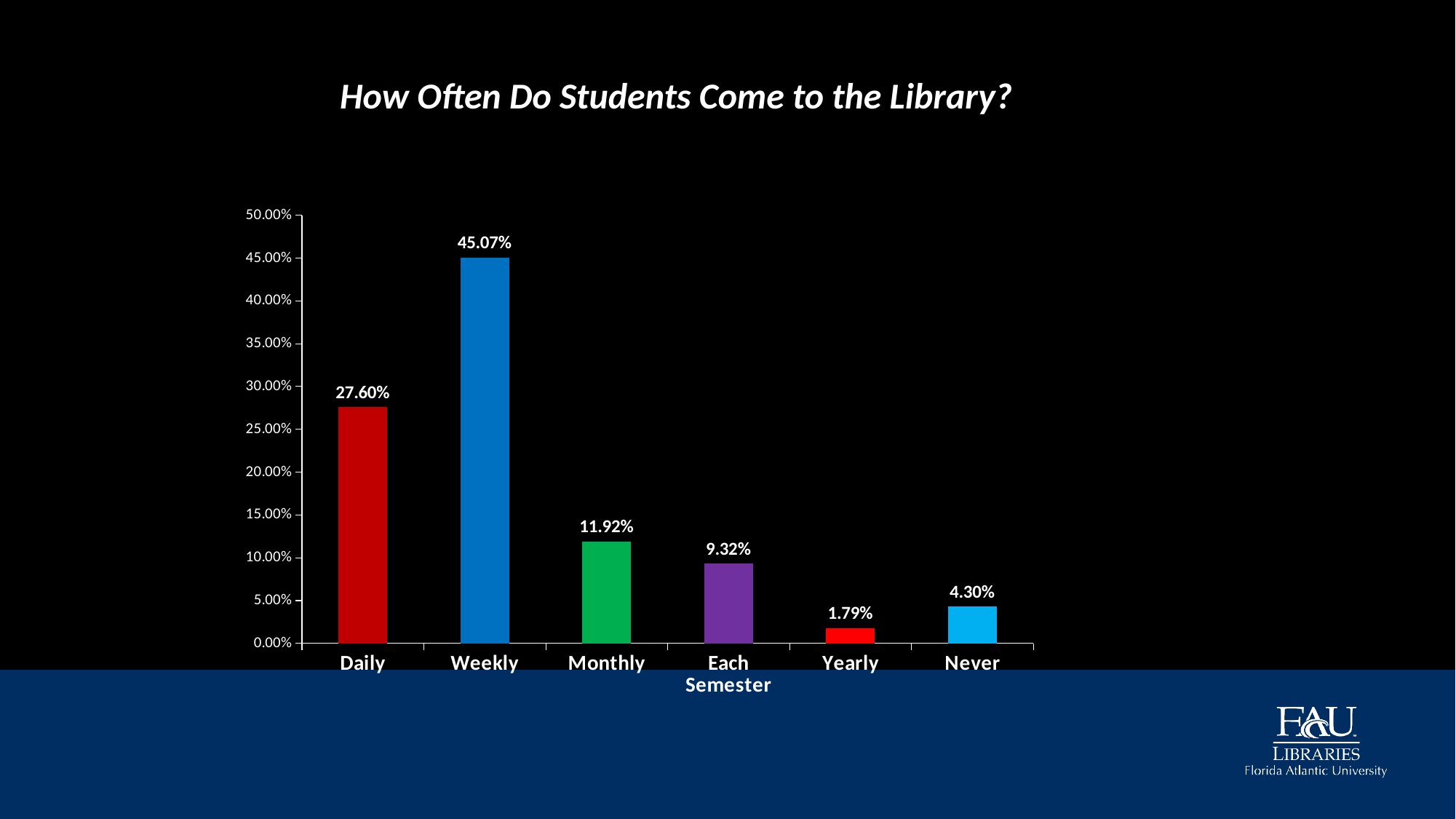
What is the value shown for Never? 4.30% How many categories are shown on the x axis? 6 What percentage of students come to the library weekly? 45.07% What percentage of students come to the library each semester? 9.32% Which category has the lowest value? Yearly Which category has the highest value? Weekly What is the value shown for Daily? 27.60% What is the title of the chart? How Often Do Students Come to the Library? Which is larger, the value for Monthly or the value for Never? Monthly What is the difference between the Monthly and Each Semester values? 2.60% What is the difference between the Weekly and Daily values? 17.47% What kind of chart is shown on the slide? Bar chart